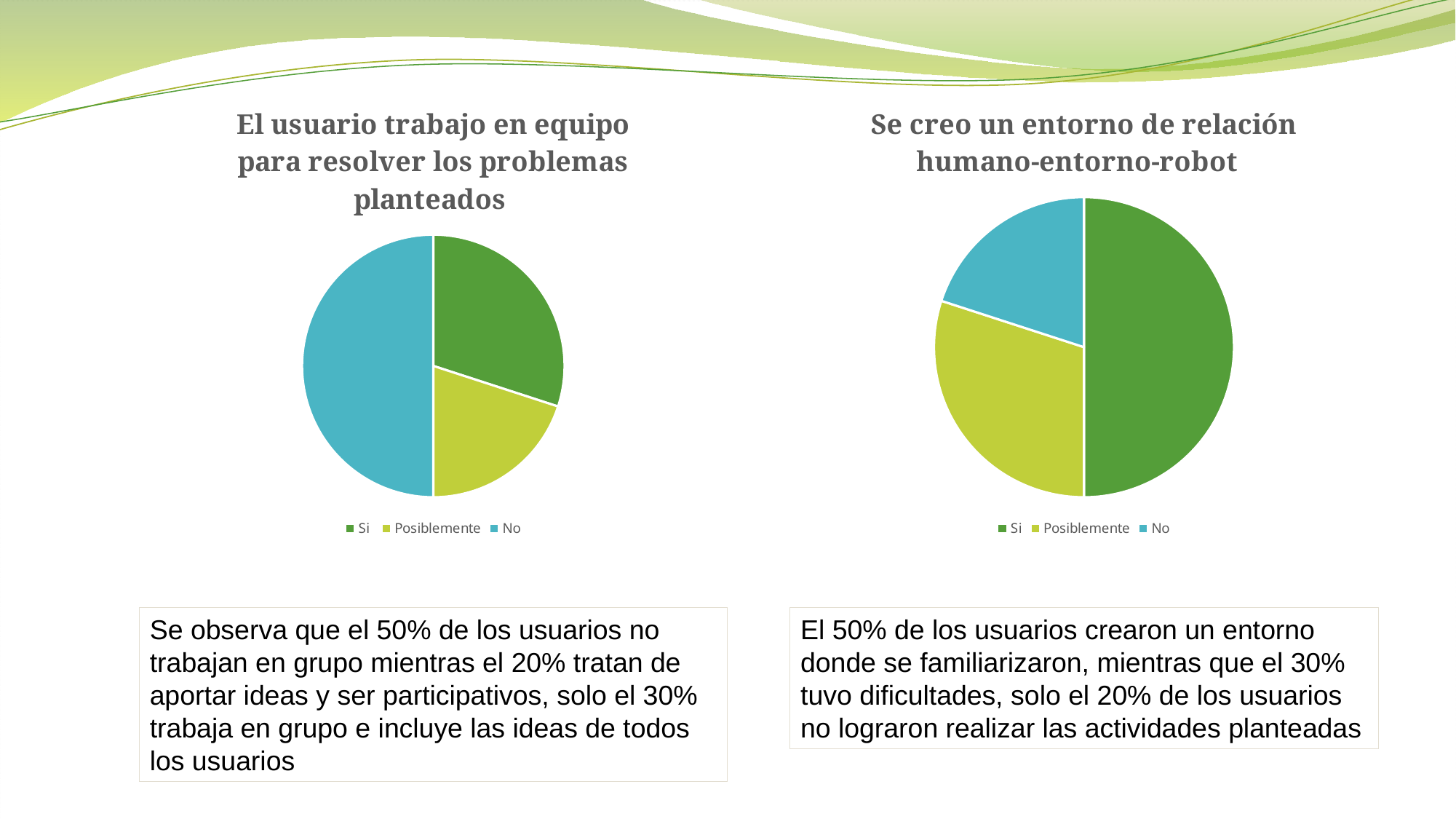
In the right chart ("Se creo un entorno de relación humano-entorno-robot"), which category has the largest slice? Si How many slices does the left chart ("El usuario trabajo en equipo...") have? 3 In the left chart ("El usuario trabajo en equipo..."), which category has the largest slice? No In the right chart ("Se creo un entorno de relación humano-entorno-robot"), which category has the smallest slice? No What kind of chart is the one titled "El usuario trabajo en equipo para resolver los problemas planteados"? Pie chart What kind of chart is the one titled "Se creo un entorno de relación humano-entorno-robot"? Pie chart In the left chart ("El usuario trabajo en equipo..."), what colour is the No slice? Blue In the left chart ("El usuario trabajo en equipo..."), which category has the smallest slice? Posiblemente How many entries does the legend of the right chart ("Se creo un entorno de relación humano-entorno-robot") list? 3 In the left chart ("El usuario trabajo en equipo..."), which slice is larger, Si or Posiblemente? Si What are the legend entries of the right chart ("Se creo un entorno de relación humano-entorno-robot")? Si, Posiblemente, No In the right chart ("Se creo un entorno de relación humano-entorno-robot"), which slice is larger, Posiblemente or No? Posiblemente